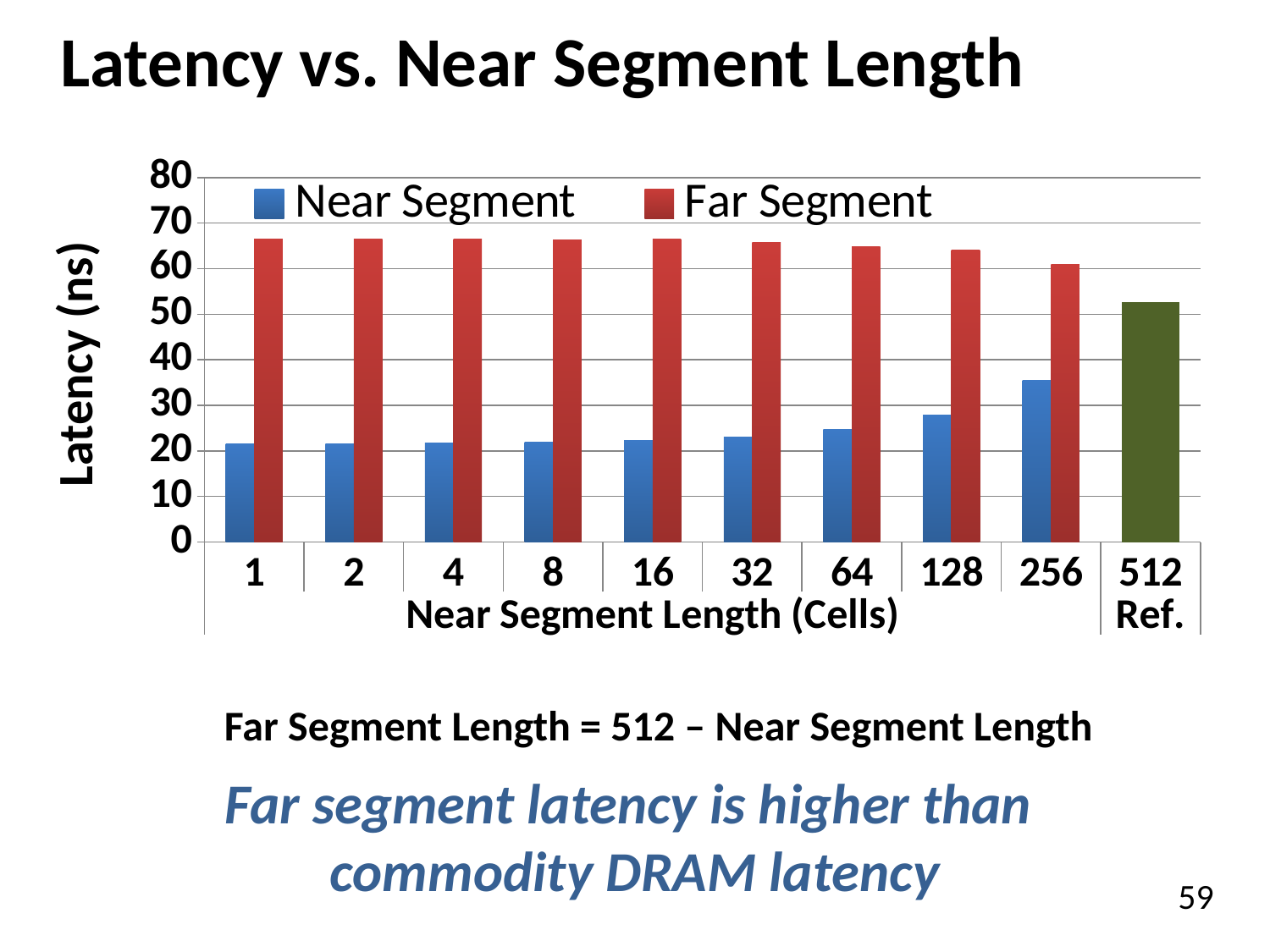
At which near segment length is the Far Segment latency lowest? 256 Is the latency for 512 Ref. greater or less than 50? greater At which near segment length is the Near Segment latency highest? 256 Does the Near Segment latency rise or fall as the near segment length increases from 1 to 256? rise At near segment length 64, which is larger: the Near Segment latency or the Far Segment latency? Far Segment Is the Near Segment latency at near segment length 1 greater or less than 30? less What is the label of the y axis? Latency (ns) How many categories are shown along the x axis? 10 Is the Near Segment latency at near segment length 256 greater or less than 30? greater What kind of chart is shown on the slide? bar chart How many series does the legend list? 2